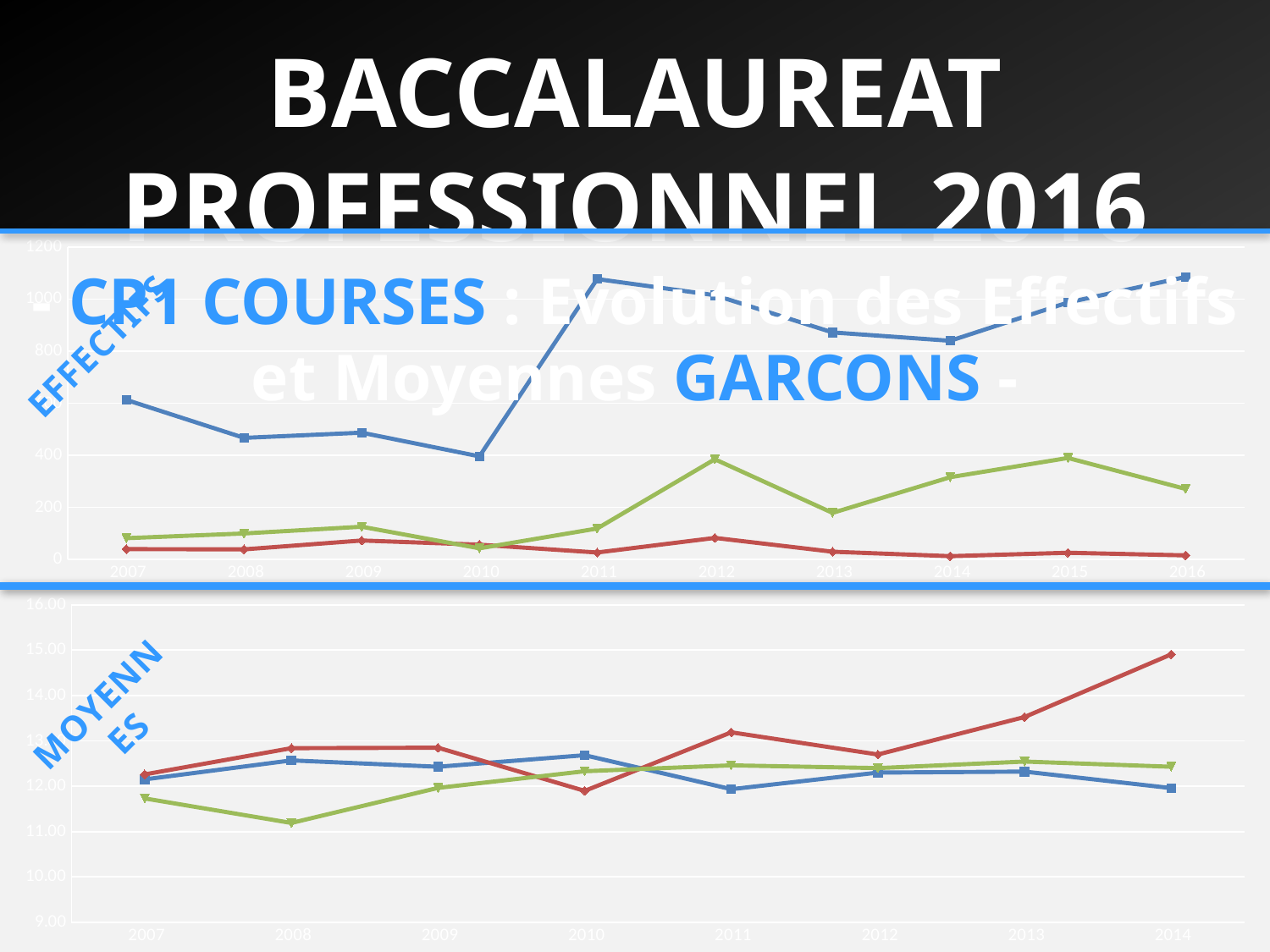
What type of chart is the top chart labelled EFFECTIFS? Line chart In the bottom chart (MOYENNES), does the red line rise or fall from 2012 to 2014? Rises In the top chart (EFFECTIFS), is the value of the green line in 2012 greater or less than 200? greater How many years are shown on the x axis of the bottom chart (MOYENNES)? 8 In the top chart (EFFECTIFS), which line has the larger value in 2016, the blue line or the green line? The blue line In the top chart (EFFECTIFS), is the value of the blue line in 2011 greater or less than 1000? greater In the bottom chart (MOYENNES), is the value of the red line in 2014 greater or less than 14.00? greater How many years are shown on the x axis of the top chart (EFFECTIFS)? 10 How many charts are shown on the slide? 2 In the bottom chart (MOYENNES), in which year does the green line reach its lowest value? 2008 In the bottom chart (MOYENNES), in which year does the red line reach its highest value? 2014